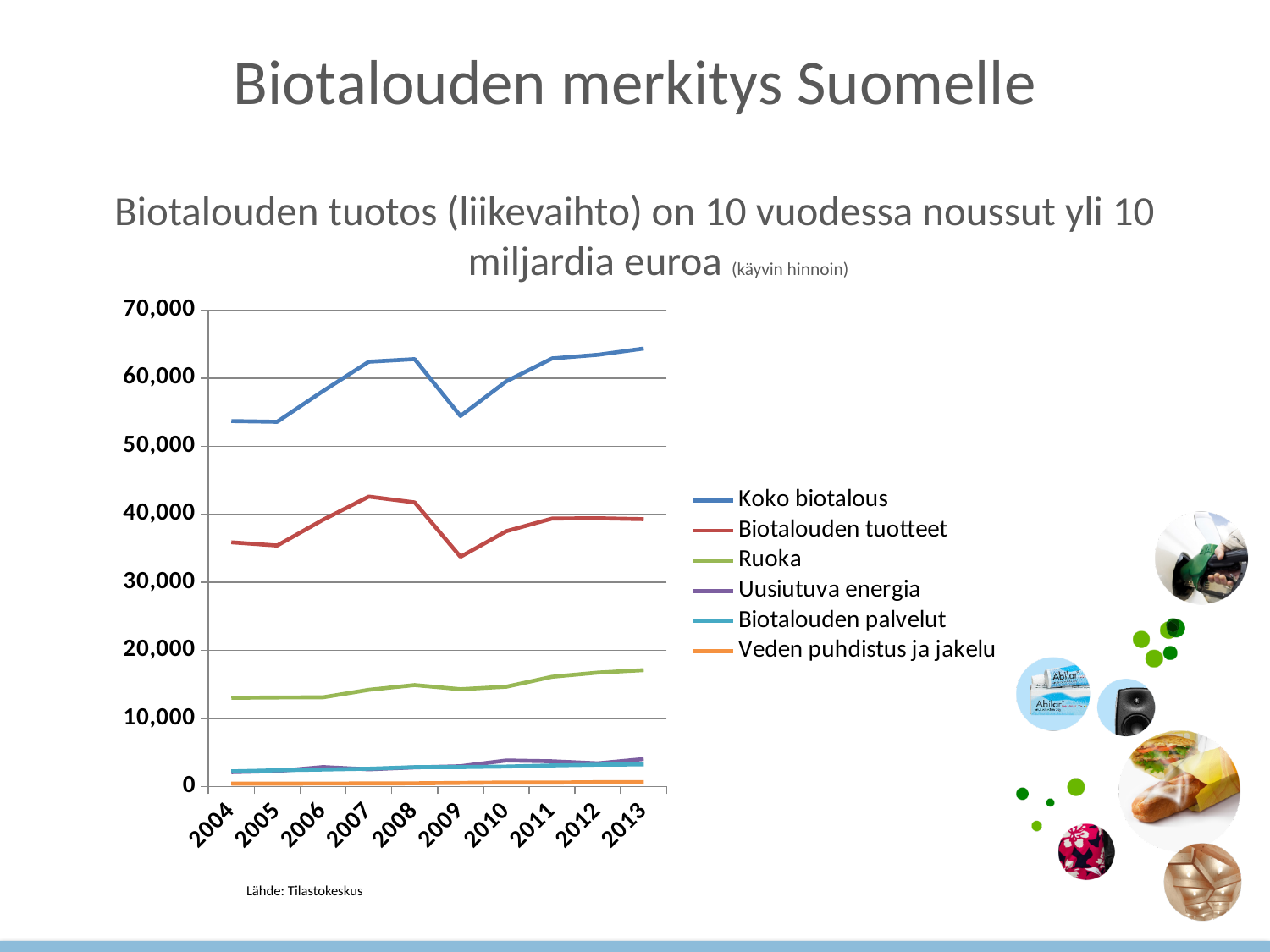
How many series does the legend list? 6 Does the Ruoka series rise or fall overall from 2004 to 2013? rise For Koko biotalous, which year has the larger value, 2009 or 2013? 2013 Is the value for Biotalouden tuotteet in 2007 greater or less than 40,000? greater Which year is the first on the x axis? 2004 Is the value for Ruoka in 2013 greater or less than 20,000? less Is the value for Koko biotalous in 2013 greater or less than 60,000? greater Which series has the highest values throughout the chart? Koko biotalous What kind of chart is shown on the slide? line chart Which series has the lowest values throughout the chart? Veden puhdistus ja jakelu How many years are shown on the x axis? 10